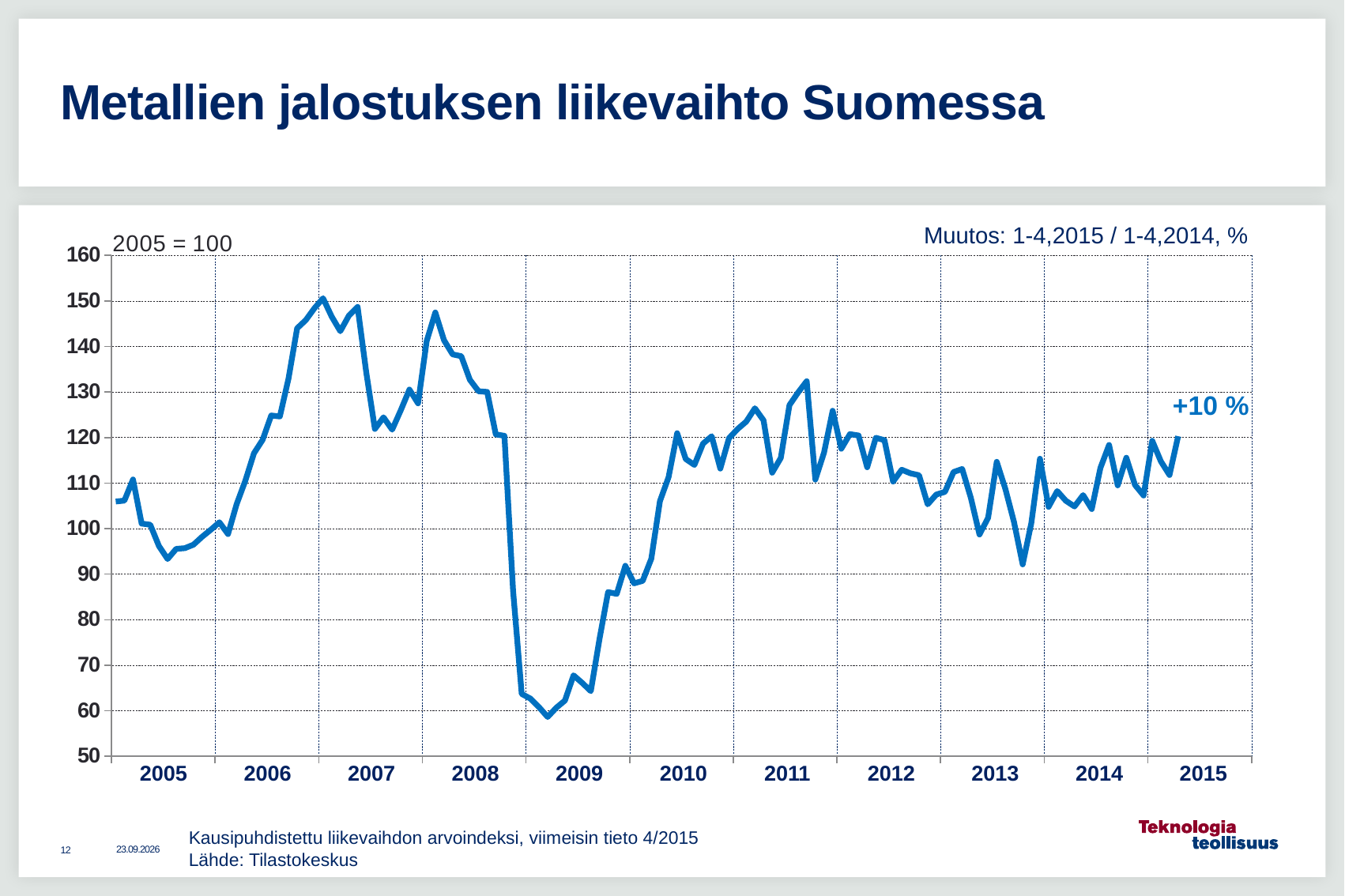
How many year labels are shown on the x axis? 11 Is the value at the start of 2005 greater or less than 100? greater Is the peak value of the line in 2006 greater or less than 140? greater Does the line rise or fall from the start of 2005 to the middle of 2006? rise What base year and value does the index use, as noted at the top left of the chart? 2005 = 100 What kind of chart is shown on the slide? line chart Is the lowest value of the line, reached around late 2008, greater or less than 70? less What is the title of the chart on the slide? Metallien jalostuksen liikevaihto Suomessa Does the line rise or fall between mid-2008 and the end of 2008? fall What percentage change is annotated at the right end of the line? +10 %